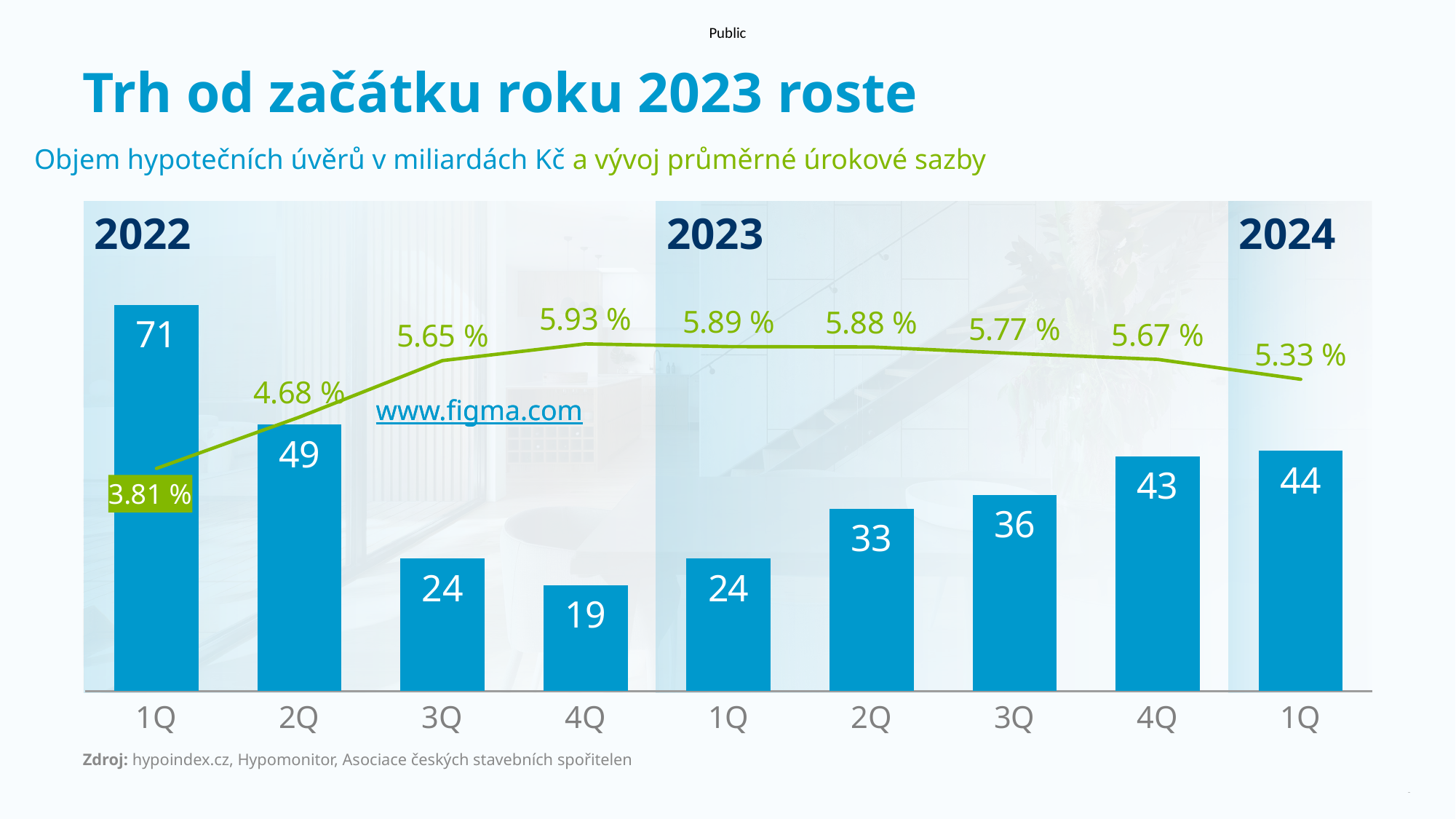
Which quarter has the lowest average interest rate? 1Q 2022 Which quarter has the highest mortgage loan volume? 1Q 2022 What is the difference in mortgage loan volume between 4Q 2023 and 3Q 2023? 7 What is the average interest rate shown for 1Q 2024? 5.33 % How many quarters are plotted on the chart? 9 What kind of chart is used to show the mortgage loan volumes? Bar chart Which quarter has the lowest mortgage loan volume? 4Q 2022 What is the average interest rate shown for 4Q 2022? 5.93 % What is the mortgage loan volume (in billions of Kč) for 1Q 2022? 71 Do the mortgage loan volumes rise or fall from 1Q 2023 to 1Q 2024? Rise Which is larger, the mortgage loan volume for 2Q 2022 or for 4Q 2023? 2Q 2022 What is the mortgage loan volume for 1Q 2024? 44